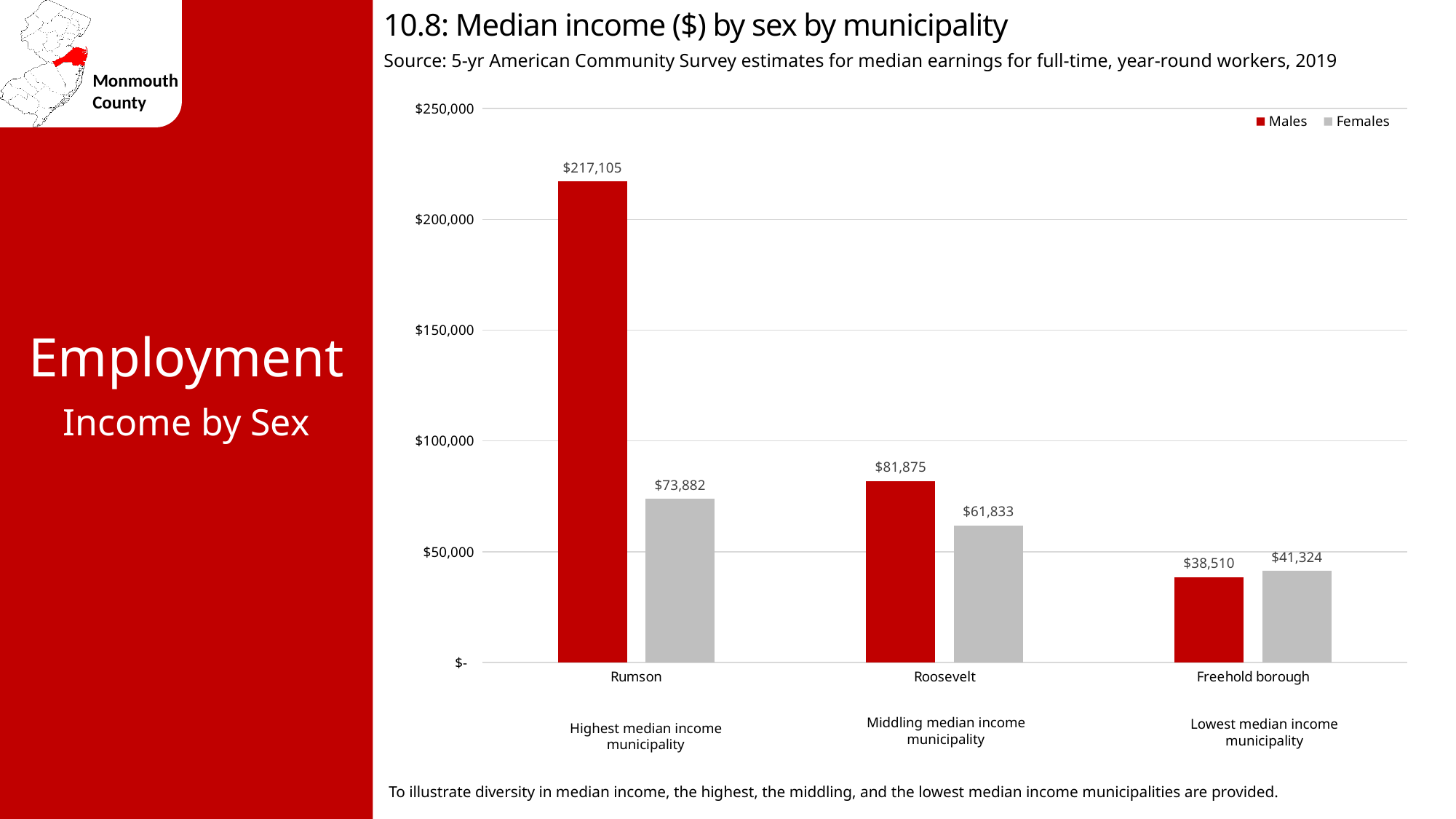
Which municipality has the highest median income for males? Rumson Is the median income for males in Rumson greater or less than $200,000? greater Which municipality has the lowest median income for females? Freehold borough What is the median income for females in Freehold borough? $41,324 How many series does the legend list? 2 In Freehold borough, which is larger, the male or the female median income? Female How many municipalities are shown on the chart? 3 What kind of chart is shown on the slide? Bar chart What is the difference between male and female median income in Roosevelt? $20,042 What is the median income for males in Rumson? $217,105 What is the difference between male and female median income in Rumson? $143,223 What is the median income for females in Roosevelt? $61,833